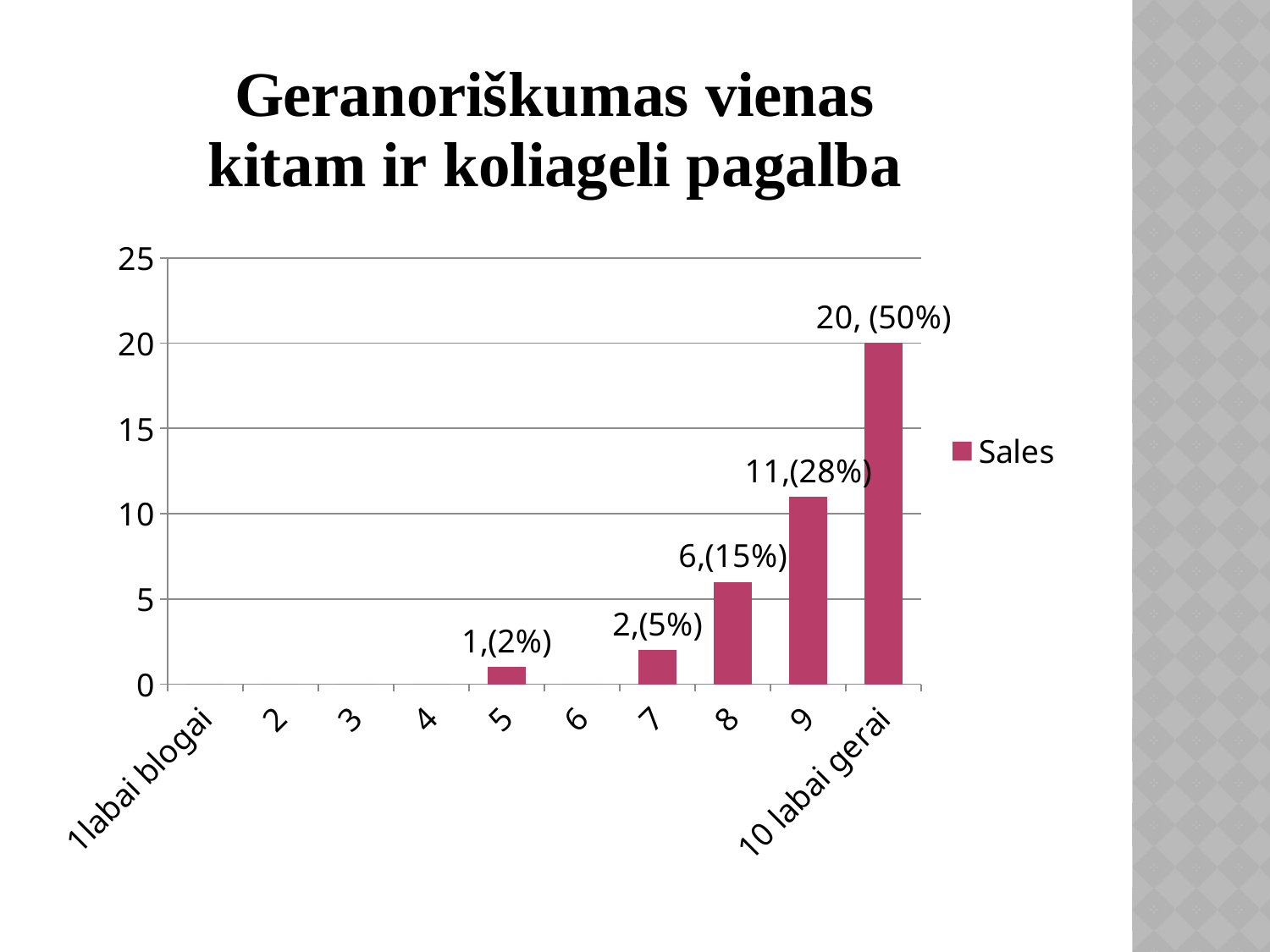
What is the difference between the values for 8 and 7? 4 What is the data label on the bar for category 8? 6,(15%) Is the value for '10 labai gerai' greater or less than 15? greater What kind of chart is shown on the slide? bar chart What is the data label on the bar for category 5? 1,(2%) How many categories are shown on the x axis? 10 What is the data label on the bar for category 9? 11,(28%) What is the difference between the values for '10 labai gerai' and 9? 9 Which is larger, the value for 9 or the value for 8? 9 How many series does the legend list? 1 What is the data label on the bar for category '10 labai gerai'? 20, (50%) Which category has the highest bar? 10 labai gerai